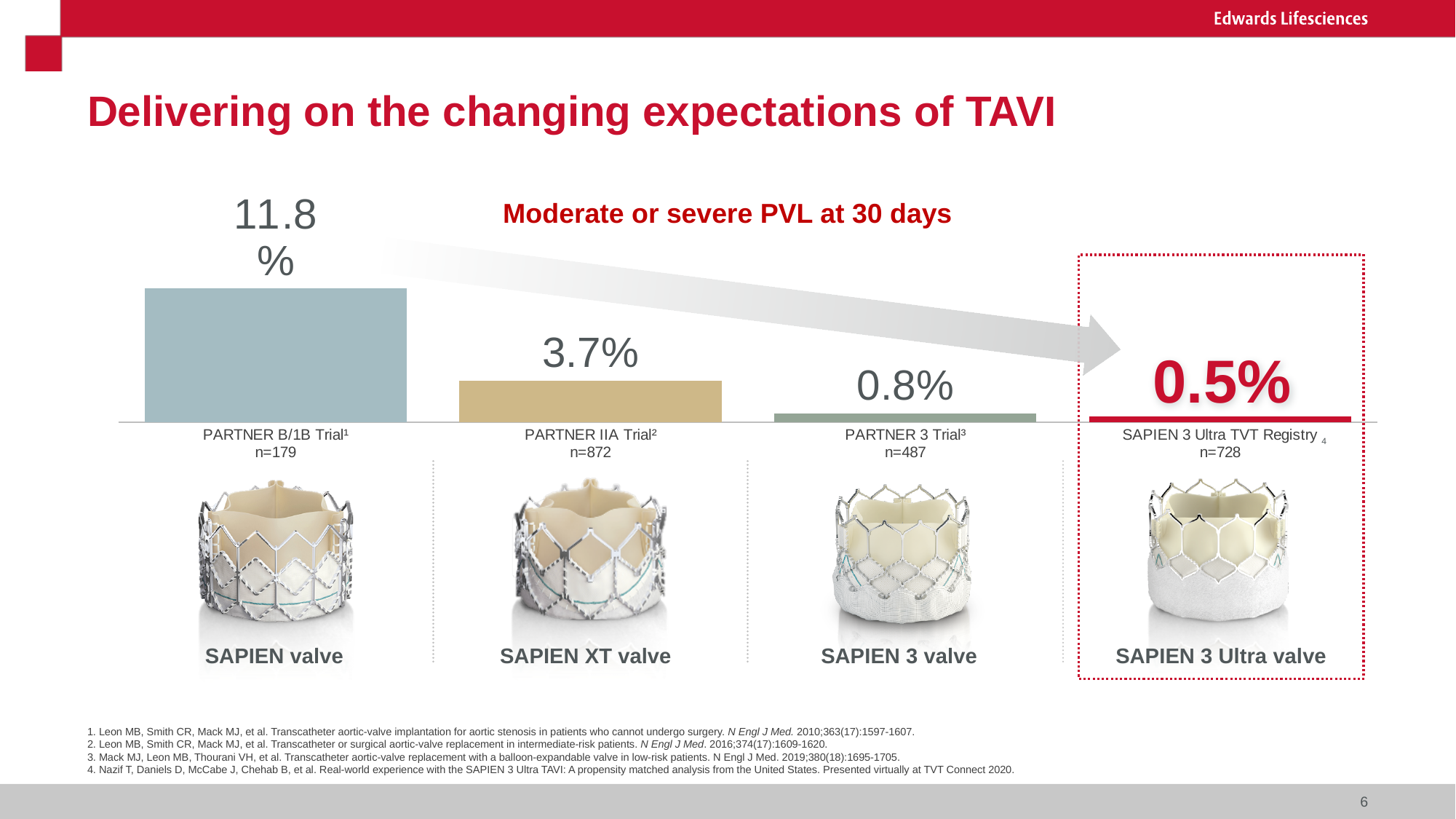
Do the PVL rates rise or fall from left to right across the chart? Fall Which trial or registry has the lowest moderate or severe PVL rate at 30 days? SAPIEN 3 Ultra TVT Registry What is the moderate or severe PVL rate at 30 days for the PARTNER B/1B Trial? 11.8% What is the moderate or severe PVL rate at 30 days for the PARTNER 3 Trial? 0.8% Which has a higher PVL rate, the PARTNER IIA Trial or the PARTNER 3 Trial? PARTNER IIA Trial What is the moderate or severe PVL rate at 30 days for the PARTNER IIA Trial? 3.7% What is the moderate or severe PVL rate at 30 days for the SAPIEN 3 Ultra TVT Registry? 0.5% What is the difference in PVL rate between the PARTNER 3 Trial and the SAPIEN 3 Ultra TVT Registry? 0.3% Which trial or registry has the highest moderate or severe PVL rate at 30 days? PARTNER B/1B Trial What is the difference in PVL rate between the PARTNER B/1B Trial and the PARTNER IIA Trial? 8.1% How many trials or registries are shown as bars in the chart? 4 What kind of chart is used to show the PVL rates? Bar chart